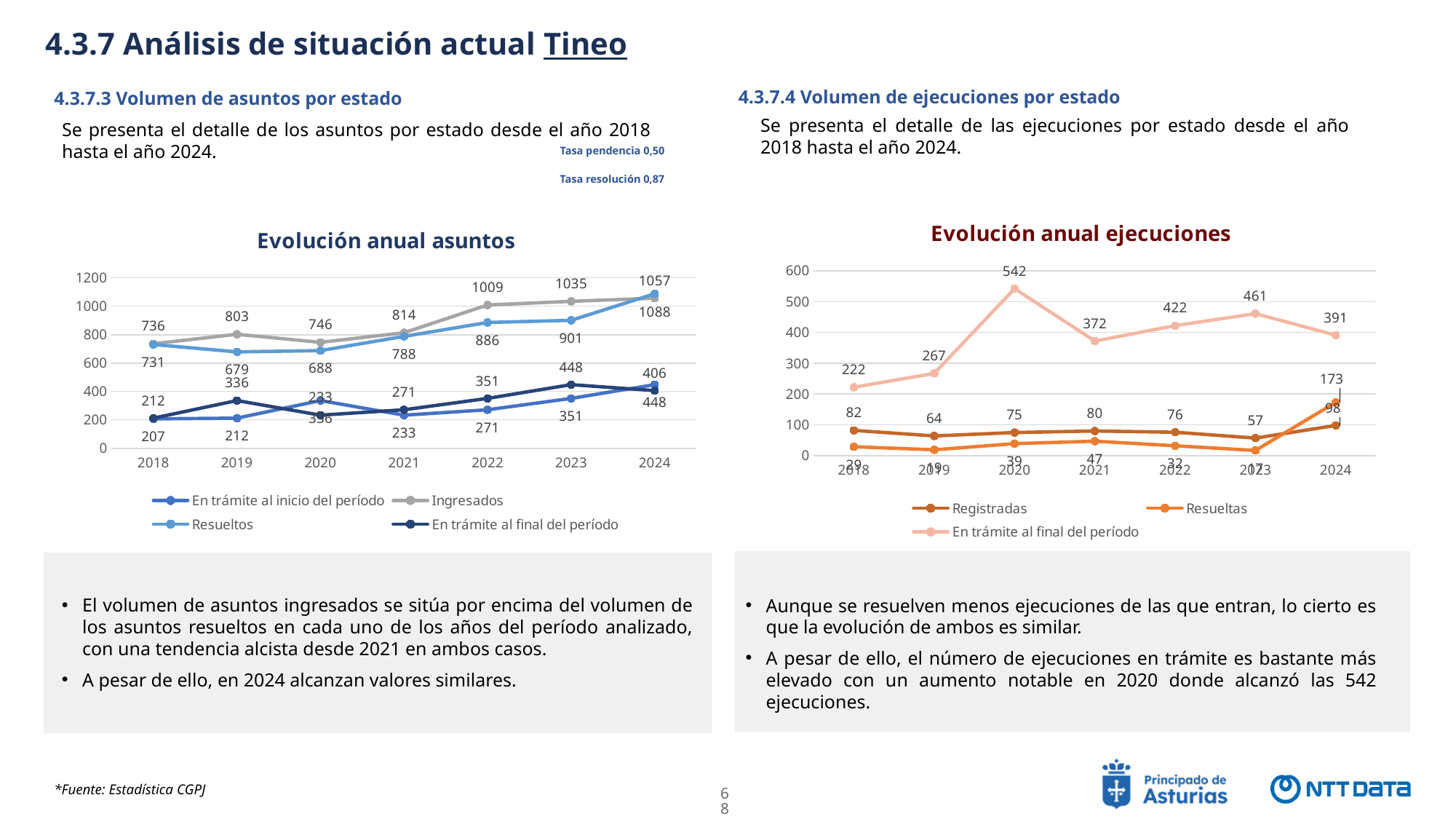
In the 'Evolución anual ejecuciones' chart, what is the value of Registradas in 2023? 57 In the 'Evolución anual ejecuciones' chart, what is the value of En trámite al final del período in 2020? 542 In the 'Evolución anual asuntos' chart, what is the value of Ingresados in 2022? 1009 In the 'Evolución anual ejecuciones' chart, in which year is Resueltas highest? 2024 In the 'Evolución anual asuntos' chart, what is the difference between Ingresados and Resueltos in 2023? 134 In the 'Evolución anual ejecuciones' chart, which is larger in 2024, Registradas or Resueltas? Resueltas In the 'Evolución anual asuntos' chart, in which year is Ingresados highest? 2024 In the 'Evolución anual ejecuciones' chart, how many years are shown on the x axis? 7 In the 'Evolución anual asuntos' chart, how many series does the legend list? 4 In the 'Evolución anual asuntos' chart, what is the value of Resueltos in 2024? 1088 What type of chart is 'Evolución anual ejecuciones'? Line chart In the 'Evolución anual asuntos' chart, in which year is Resueltos lowest? 2019